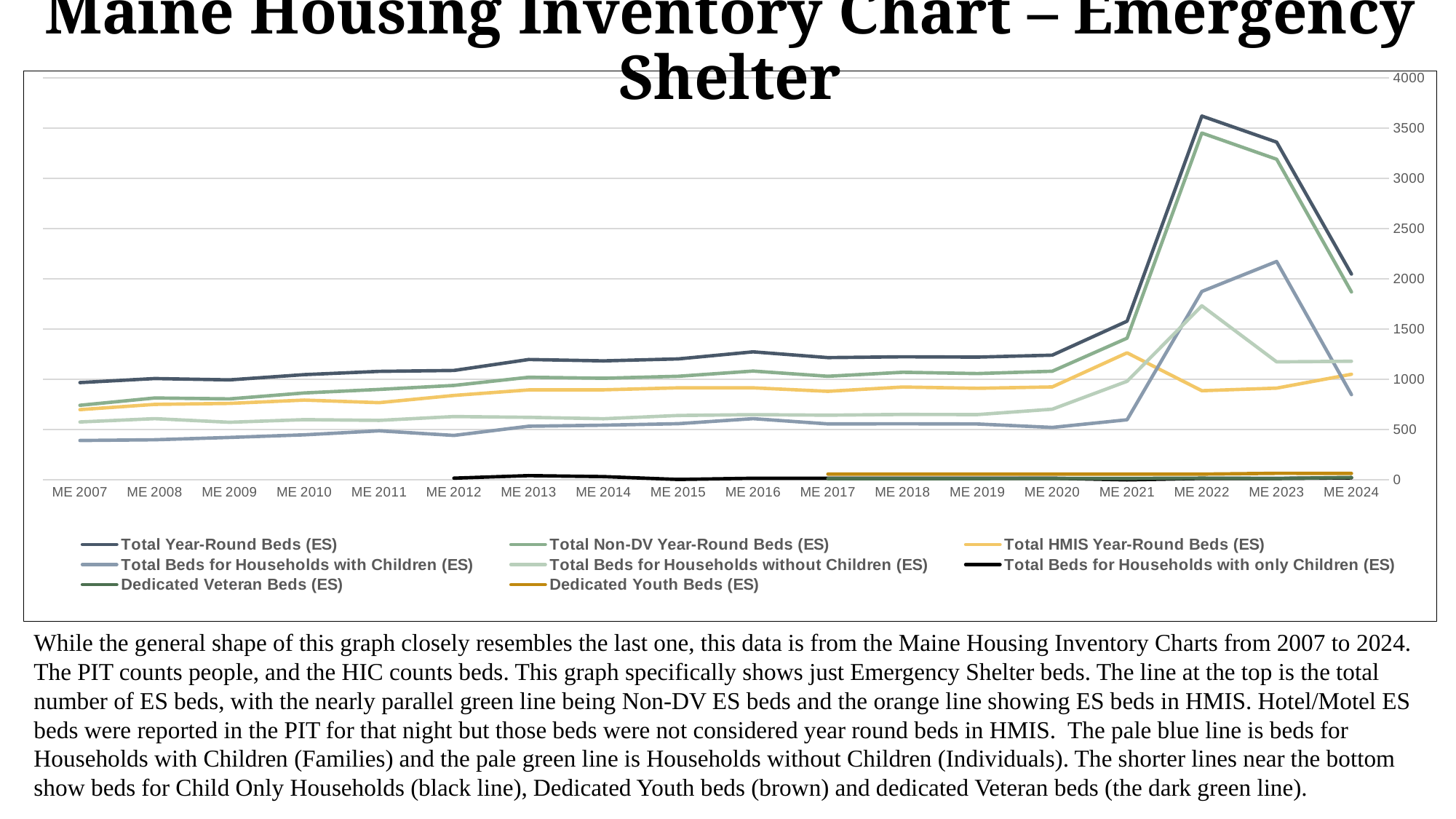
What kind of chart is shown on the slide? line chart Does the Total Year-Round Beds (ES) line rise or fall from ME 2022 to ME 2024? fall In which year does the Total Year-Round Beds (ES) line reach its highest value? ME 2022 What is the title of the chart on the slide? Maine Housing Inventory Chart – Emergency Shelter Is the value for Total Beds for Households with Children (ES) in ME 2007 greater or less than 500? less Which series in the legend is drawn with a black line? Total Beds for Households with only Children (ES) Which is larger in ME 2023: Total Beds for Households with Children (ES) or Total Beds for Households without Children (ES)? Total Beds for Households with Children (ES) Which is larger in ME 2024: Total Non-DV Year-Round Beds (ES) or Total HMIS Year-Round Beds (ES)? Total Non-DV Year-Round Beds (ES) How many series does the chart's legend list? 8 How many years (points) are shown along the x axis of the chart? 18 Is the value for Total Year-Round Beds (ES) in ME 2022 greater or less than 3500? greater Is the value for Total HMIS Year-Round Beds (ES) in ME 2021 greater or less than 1000? greater